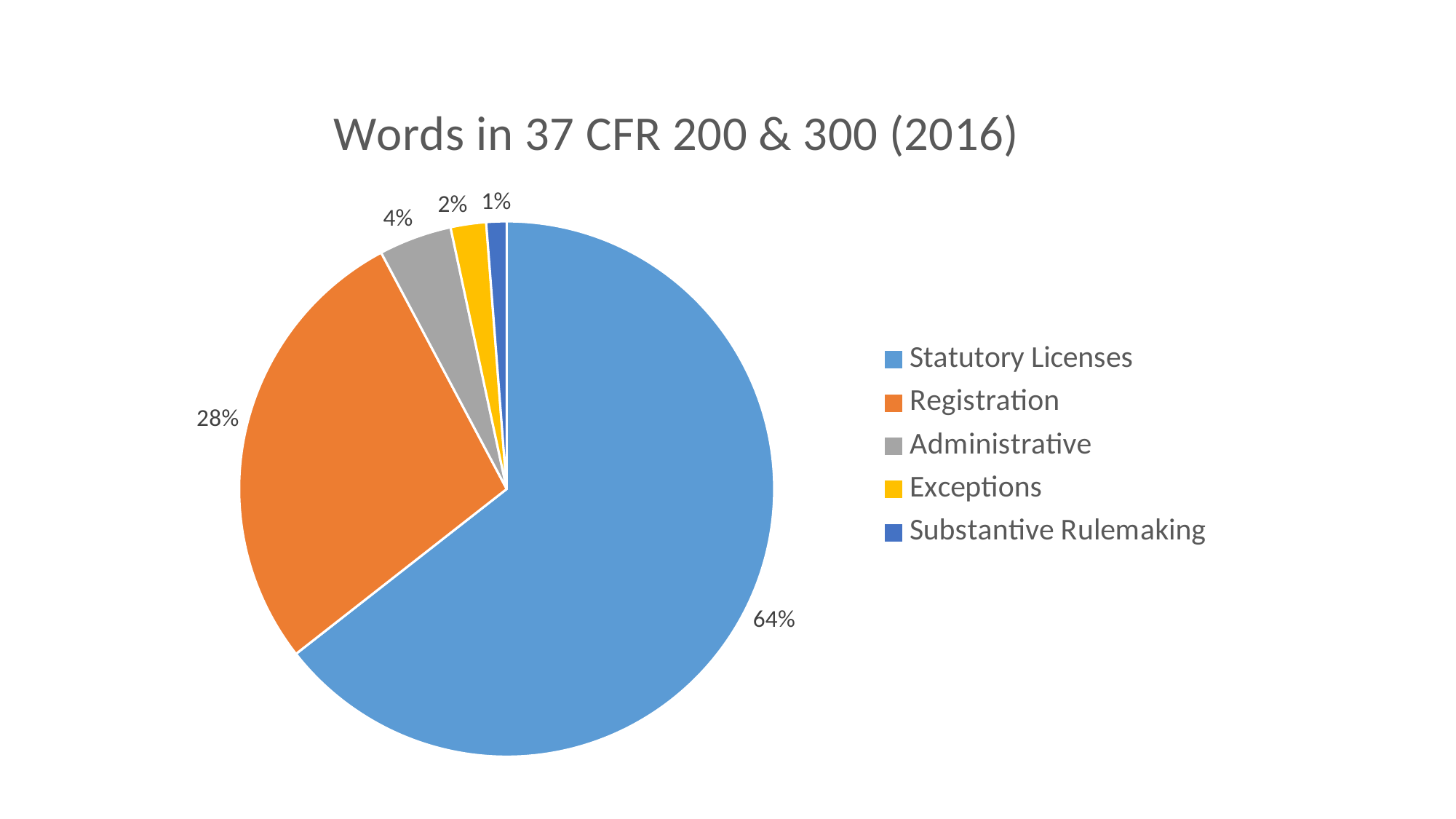
What share of the pie does Registration take? 28% What share of the pie does Statutory Licenses take? 64% What is the difference in percentage points between Statutory Licenses and Registration? 36 What share of the pie does Administrative take? 4% What is the title of the chart? Words in 37 CFR 200 & 300 (2016) Which category has the largest slice of the pie? Statutory Licenses Which category has the smallest slice of the pie? Substantive Rulemaking Which is larger, the Administrative slice or the Exceptions slice? Administrative What kind of chart is shown on the slide? Pie chart How many categories does the pie chart show? 5